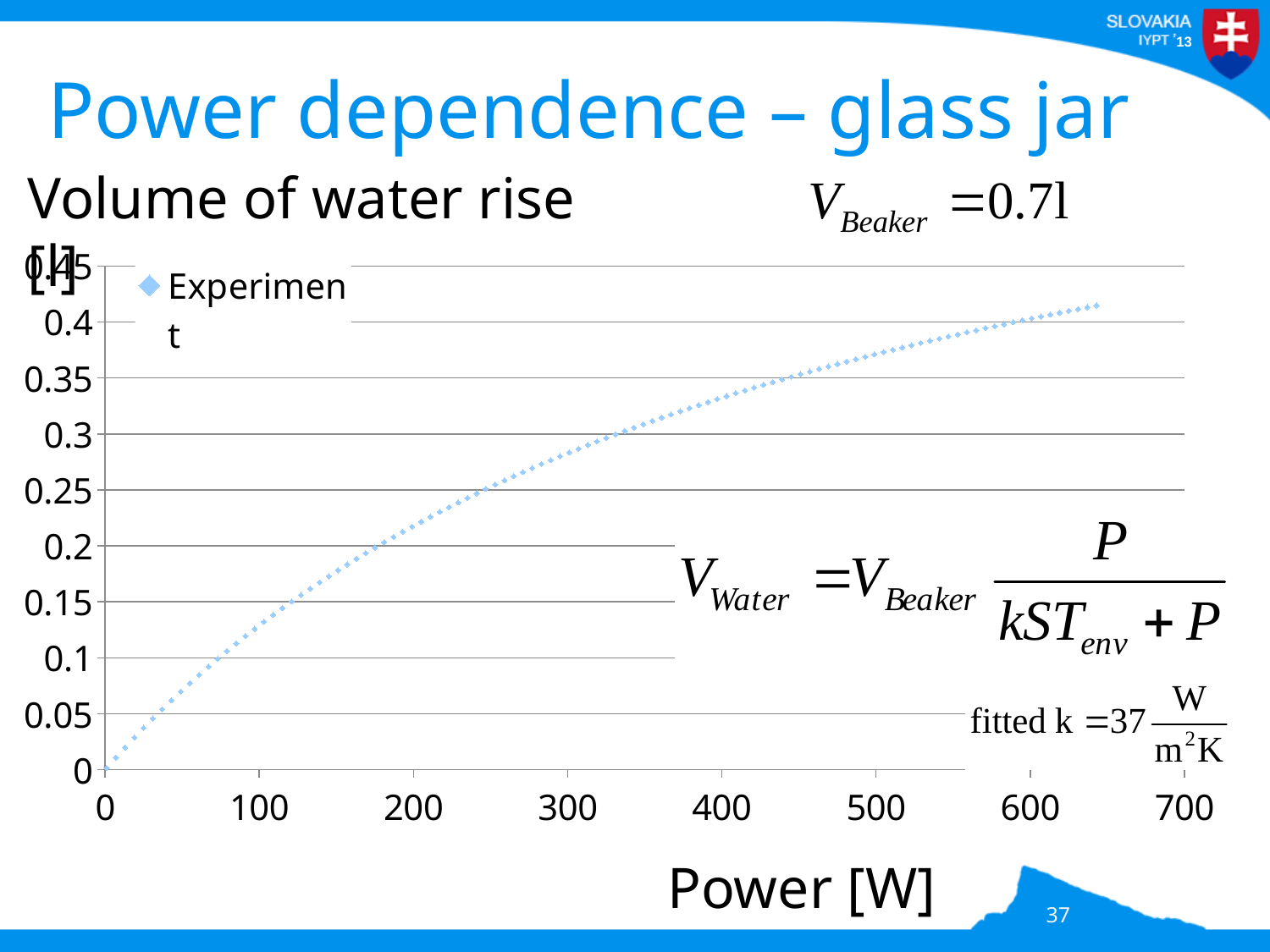
What kind of chart is shown on the slide? scatter chart What is the label of the x axis? Power [W] Do the plotted values rise or fall as power increases along the x axis? rise Is the volume of water rise at 400 W greater or less than 0.3? greater What is the name of the series shown in the legend? Experiment Is the volume of water rise at 200 W greater or less than 0.25? less How many series does the legend list? 1 Is the volume of water rise at 50 W greater or less than 0.1? less Is the value at 600 W larger or smaller than the value at 100 W? larger